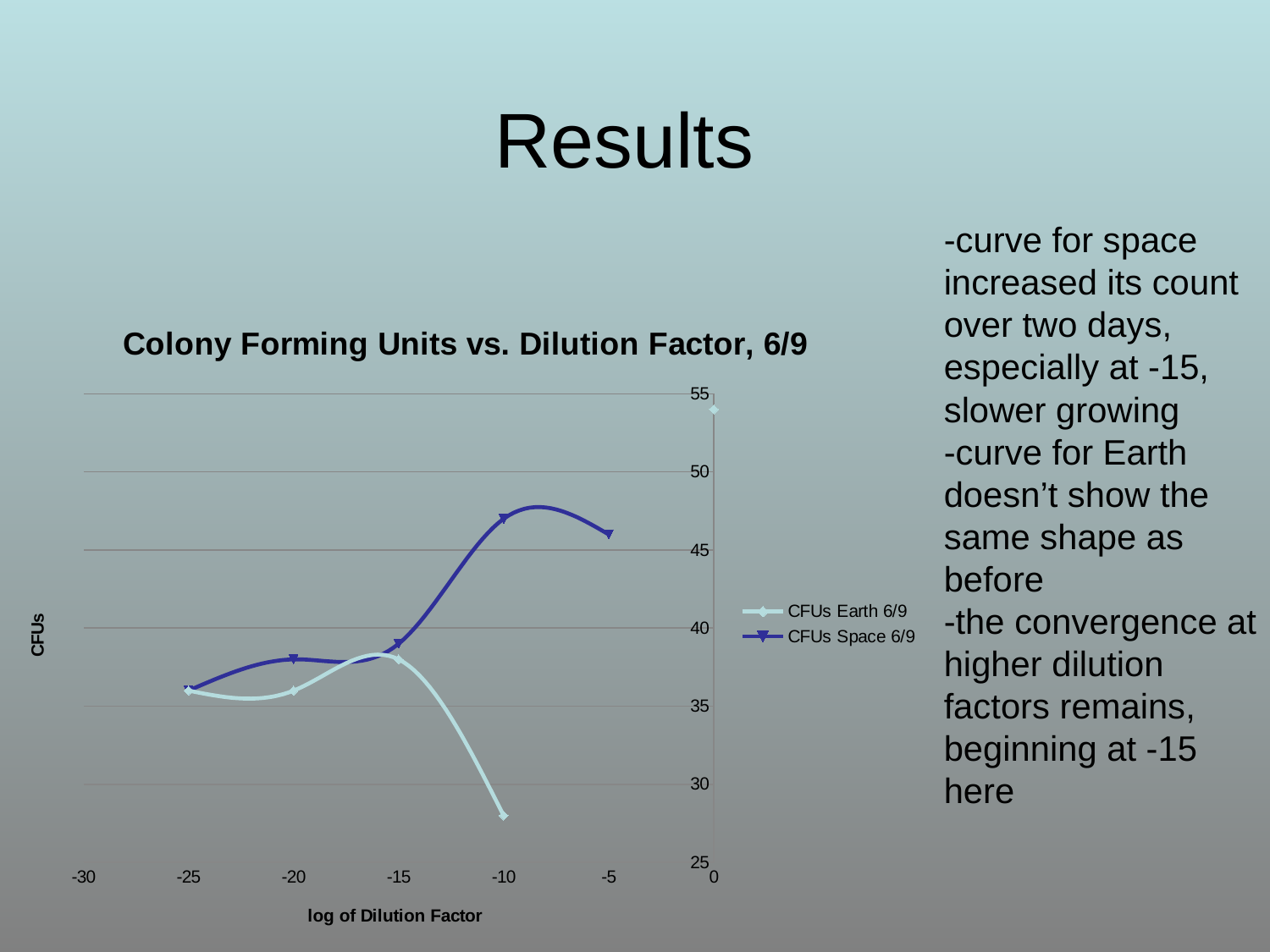
What is the label of the x axis? log of Dilution Factor Does the CFUs Earth 6/9 series rise or fall between log dilution factors -15 and -10? fall At which log dilution factor does the CFUs Space 6/9 series reach its highest value? -10 Is the value for CFUs Space 6/9 at a log dilution factor of -10 greater or less than 45? greater At which log dilution factor does the CFUs Earth 6/9 series reach its lowest value? -10 At a log dilution factor of -10, which series has the larger value, CFUs Earth 6/9 or CFUs Space 6/9? CFUs Space 6/9 Is the value for CFUs Earth 6/9 at a log dilution factor of -15 greater or less than 40? less What is the title of the chart? Colony Forming Units vs. Dilution Factor, 6/9 What kind of chart is shown on the slide? line chart Is the value for CFUs Space 6/9 at a log dilution factor of -5 greater or less than 40? greater How many series does the chart legend list? 2